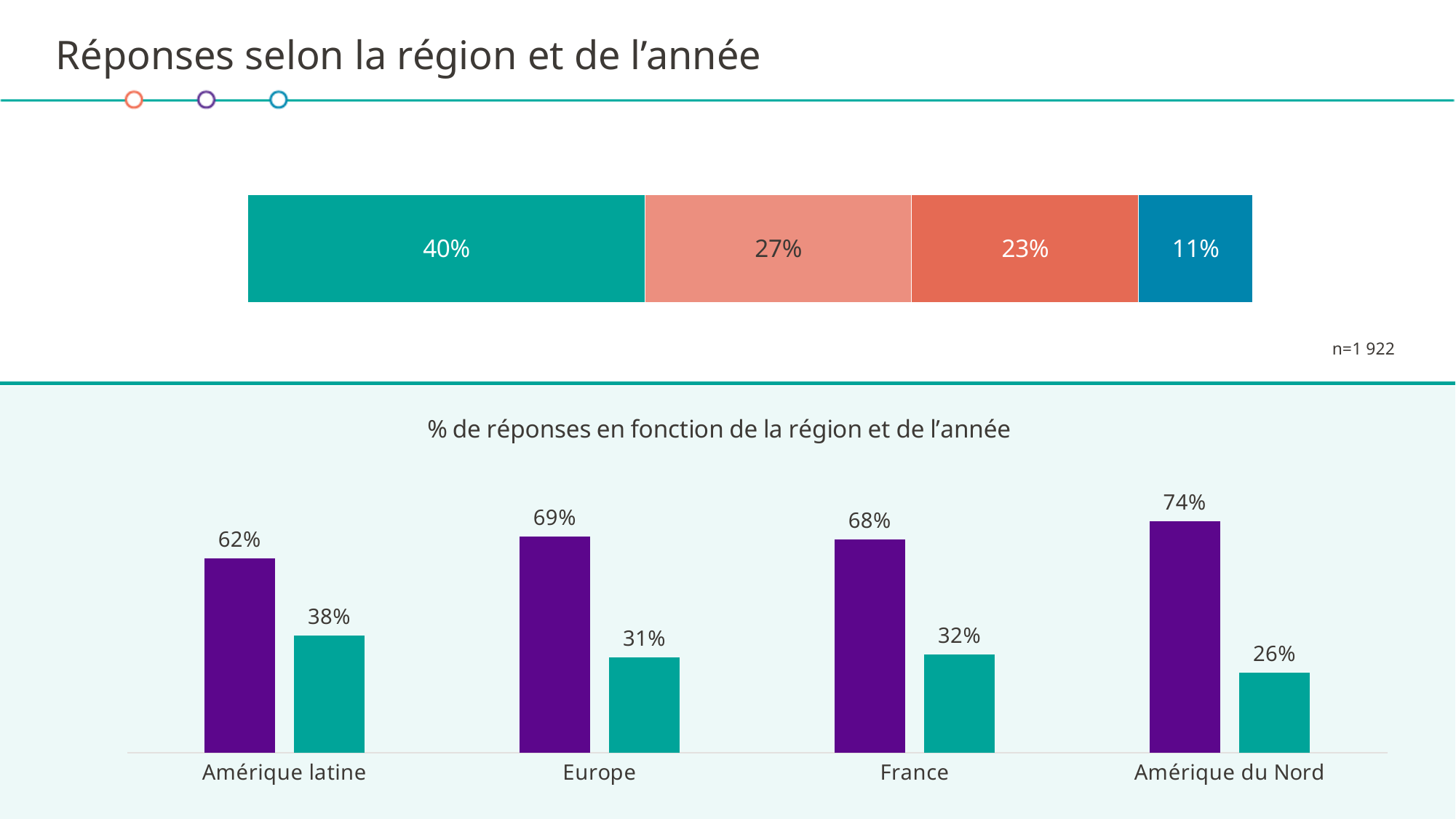
How many regions are shown on the x axis of the bottom chart? 4 In the bottom chart, what is the value of the teal bar for Europe? 31% In the bottom chart titled '% de réponses en fonction de la région et de l'année', what is the value of the purple bar for Amérique du Nord? 74% In the bottom chart, what is the difference between the purple and teal bars for Amérique latine? 24% In the top stacked bar chart, what is the value of the last (blue) segment on the right? 11% In the top stacked bar chart, what is the value of the first (teal) segment on the left? 40% In the bottom chart, is the teal bar for Amérique latine larger or smaller than the teal bar for France? larger In the bottom chart, which region has the lowest teal bar? Amérique du Nord In the bottom chart, what is the value of the purple bar for France? 68% In the bottom chart, which region has the highest purple bar? Amérique du Nord What is the title of the bottom chart? % de réponses en fonction de la région et de l'année What kind of chart is the bottom chart on the slide? bar chart